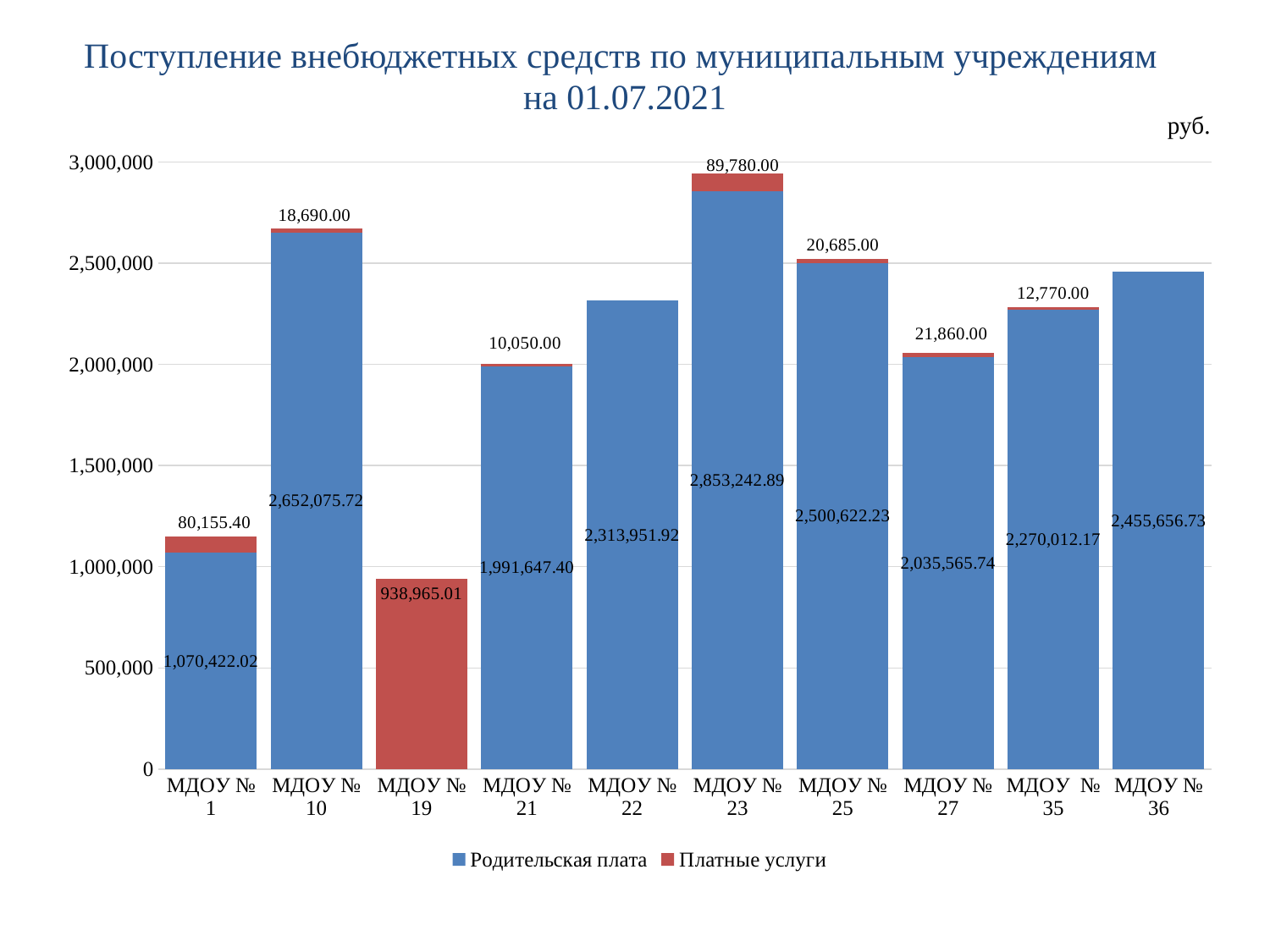
What is the total of the stacked bar for МДОУ № 1? 1,150,577.42 What type of chart is shown on the slide? Stacked bar chart What is the difference in Родительская плата between МДОУ № 10 and МДОУ № 25? 151,453.49 What is the value of Платные услуги for МДОУ № 19? 938,965.01 Which institution has the lowest labelled Платные услуги value? МДОУ № 21 How many municipal institutions (categories) are shown on the x axis? 10 Which is larger: Родительская плата for МДОУ № 36 or for МДОУ № 22? МДОУ № 36 Which institution has the highest Родительская плата? МДОУ № 23 What is the value of Родительская плата for МДОУ № 23? 2,853,242.89 What is the value of Платные услуги for МДОУ № 1? 80,155.40 Is the value for МДОУ № 19 greater or less than 1,000,000? less How many series does the legend list? 2